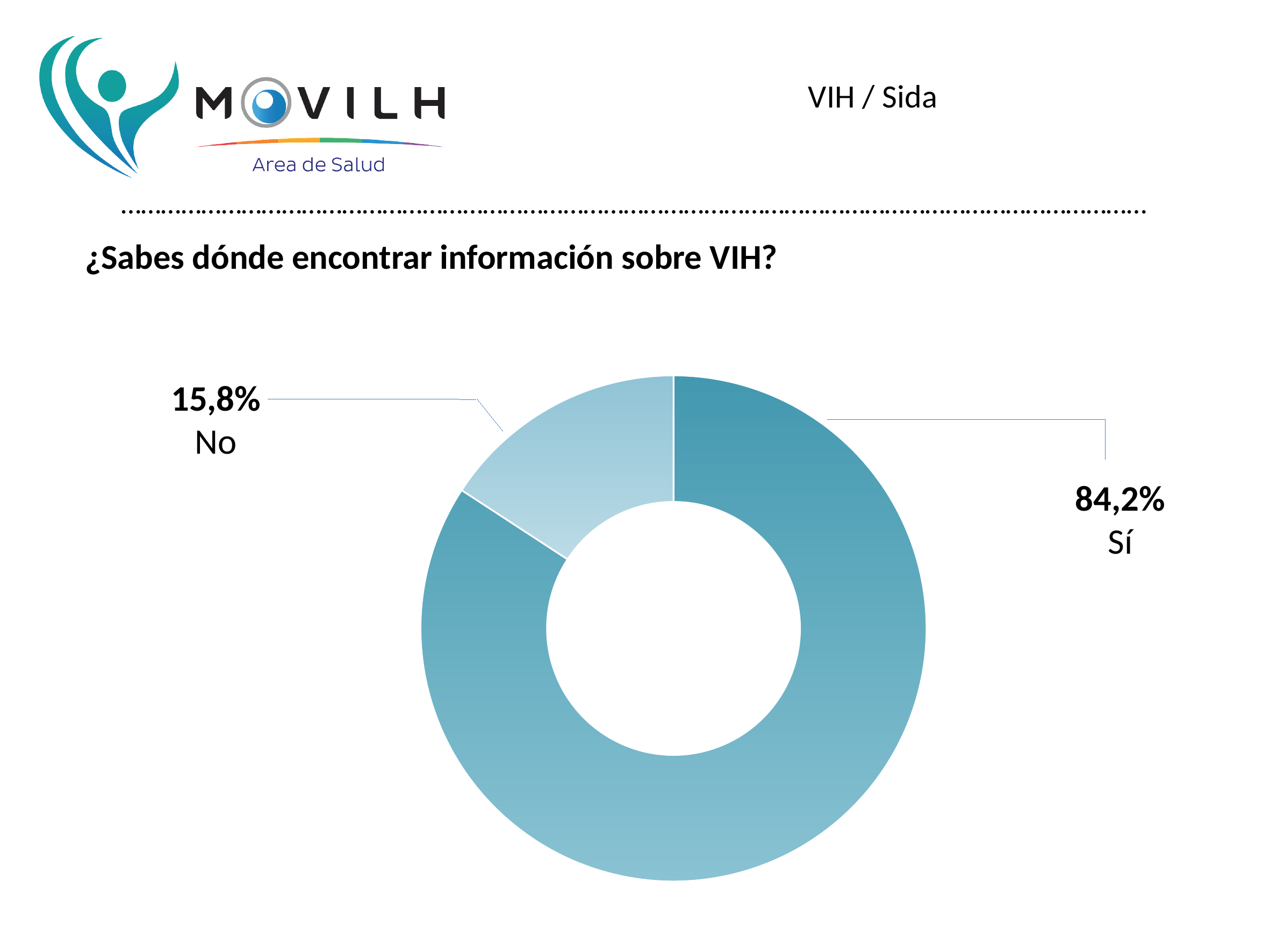
How many response categories are shown in the chart? 2 What percentage of respondents answered "No" to "¿Sabes dónde encontrar información sobre VIH?"? 15,8% Which response has the smallest share of the chart? No What kind of chart is shown on the slide? Doughnut (pie) chart Which is larger, the share for "Sí" or the share for "No"? Sí Which response has the largest share of the chart? Sí Which slice is shown in the lighter blue colour, "Sí" or "No"? No What share of the chart does the "No" slice represent? 15,8% What question does the chart on the slide answer? ¿Sabes dónde encontrar información sobre VIH? What is the difference in percentage points between the "Sí" and "No" shares? 68,4 What percentage of respondents answered "Sí" to "¿Sabes dónde encontrar información sobre VIH?"? 84,2%